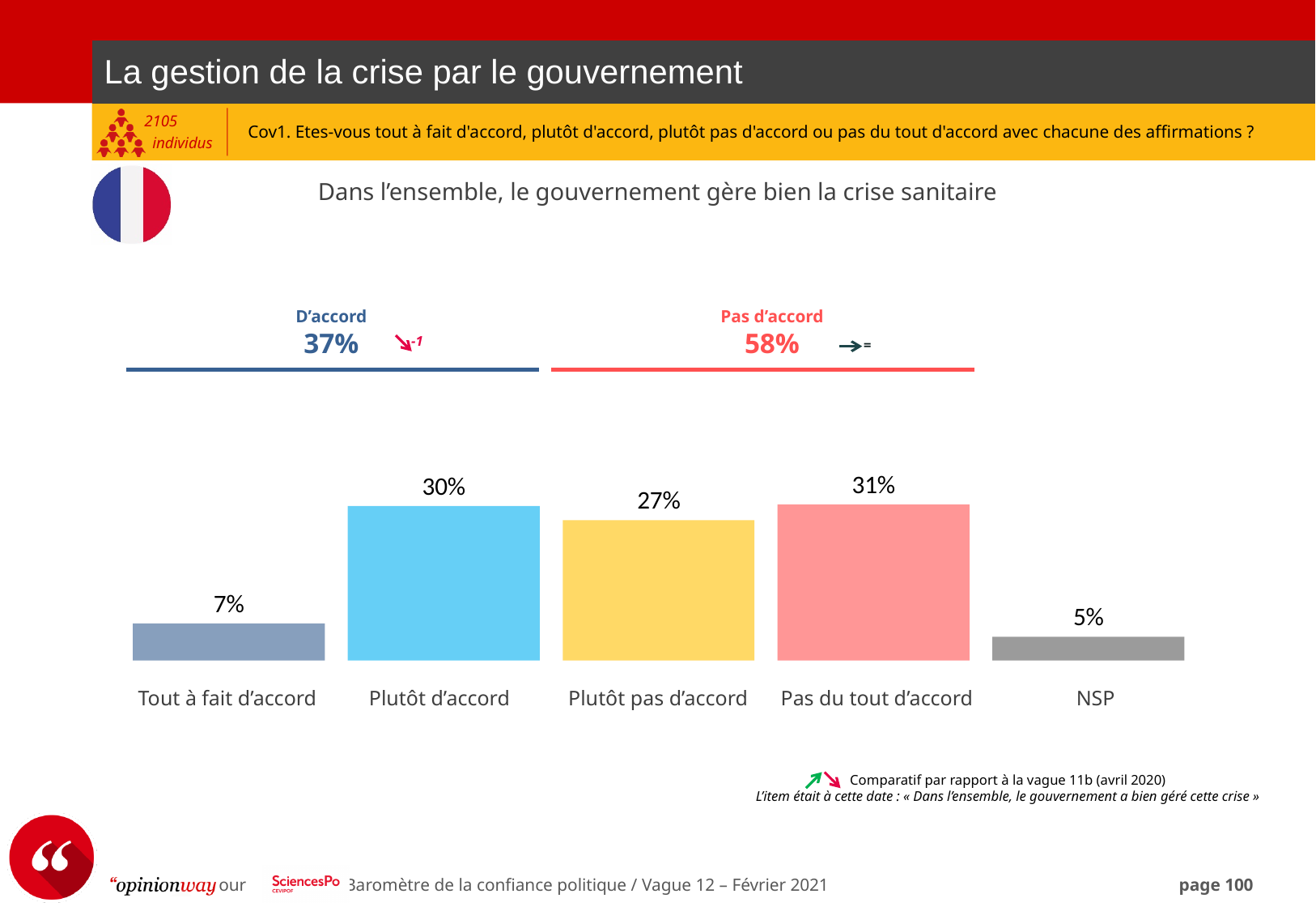
Which is larger, "Plutôt d'accord" or "Plutôt pas d'accord"? Plutôt d'accord What percentage is shown for "NSP"? 5% Which category has the lowest value? NSP What is the difference between "Pas du tout d'accord" and "Plutôt pas d'accord"? 4% Which category has the highest value? Pas du tout d'accord What statement is the chart about, as shown in the subtitle? Dans l'ensemble, le gouvernement gère bien la crise sanitaire What percentage of respondents answered "Plutôt d'accord"? 30% What is the value shown for "Tout à fait d'accord"? 7% How many categories are shown on the bar chart? 5 What is the combined "D'accord" total shown above the chart? 37% What kind of chart is shown on the slide? Bar chart What is the combined "Pas d'accord" total shown above the chart? 58%